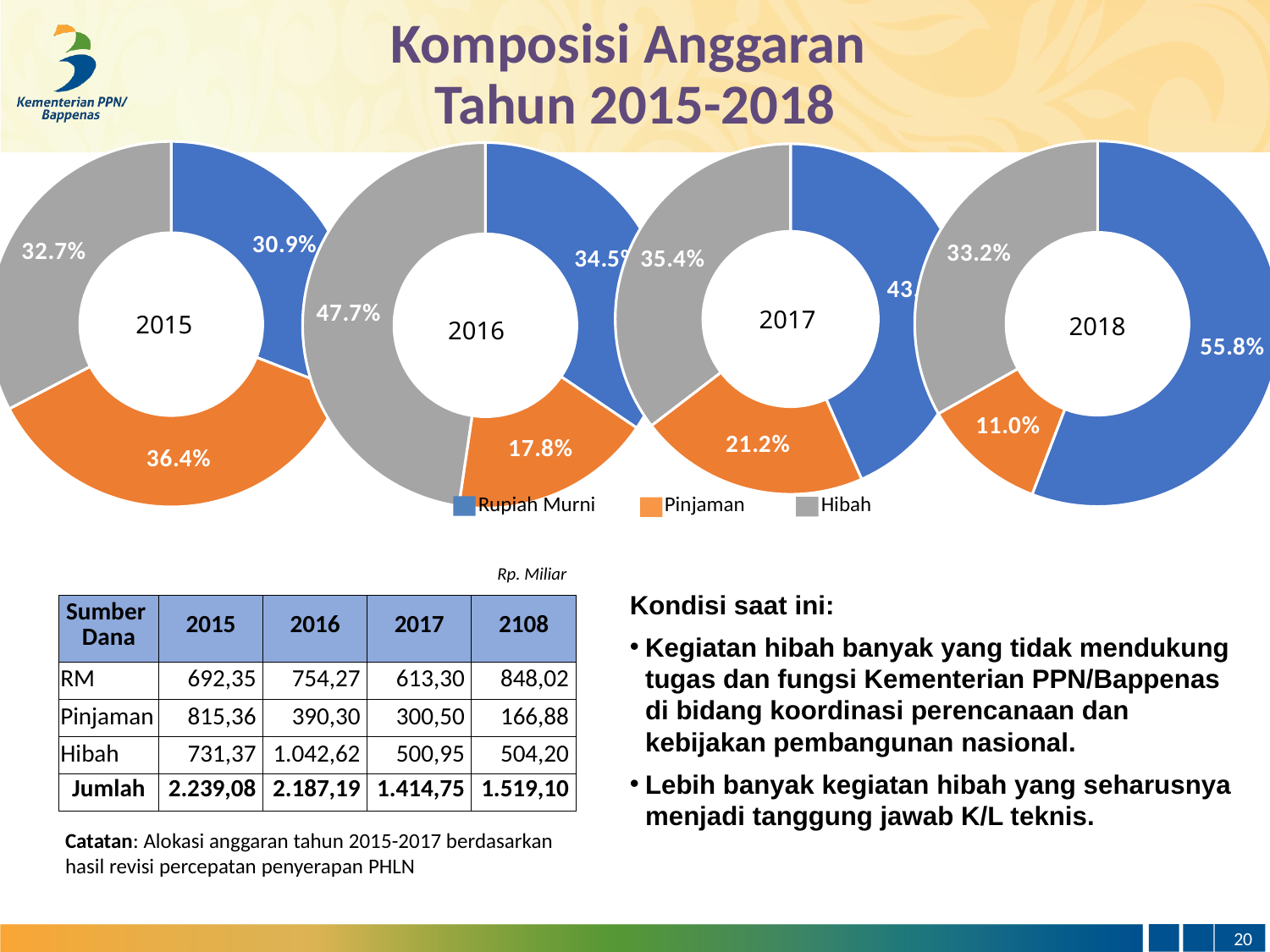
In the 2016 donut chart, which funding source has the smallest share? Pinjaman In the 2018 donut chart, which funding source has the largest share? Rupiah Murni In the 2016 donut chart, what share does Hibah have? 47.7% In the 2017 donut chart, what share does Pinjaman have? 21.2% What type of chart is used to show the budget composition for each year? Pie (donut) chart In the 2017 donut chart, what share does Hibah have? 35.4% In the 2018 donut chart, what share does Rupiah Murni have? 55.8% In the 2018 donut chart, how many percentage points larger is Rupiah Murni's share than Hibah's share? 22.6 percentage points How many series does the legend list for the donut charts? 3 In the 2015 donut chart, which is larger: the Hibah share or the Rupiah Murni share? Hibah In the 2015 donut chart, which funding source has the largest share? Pinjaman In the 2015 donut chart, what share does Pinjaman have? 36.4%